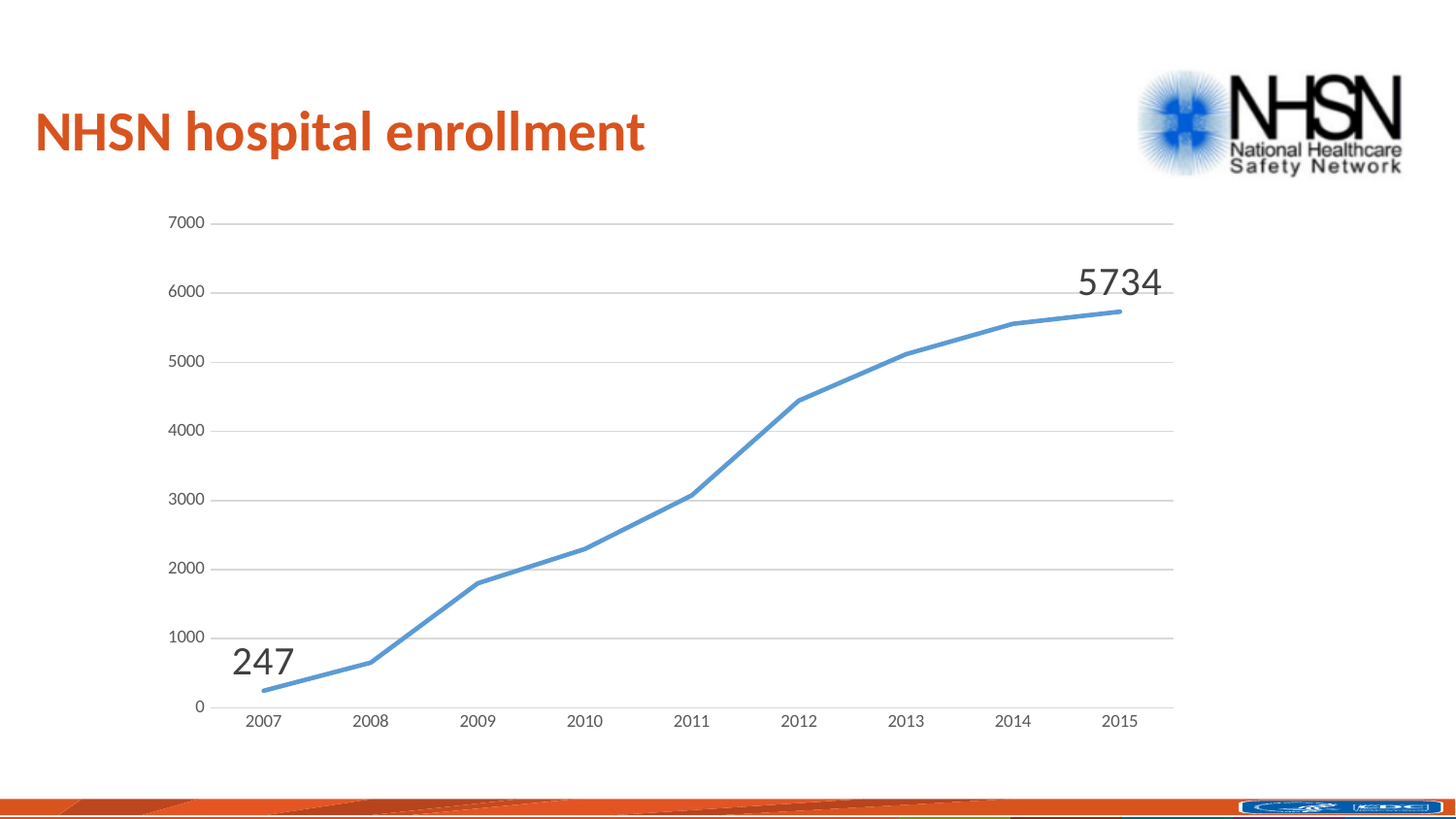
How many years are plotted on the x axis? 9 Is the value for 2009 greater or less than 2000? less Does hospital enrollment rise or fall from 2007 to 2015? rise Is the value for 2008 greater or less than 1000? less Which year has the lowest hospital enrollment? 2007 What type of chart is shown on the slide? line chart What is the title of the chart on the slide? NHSN hospital enrollment What is the NHSN hospital enrollment value for 2007? 247 Which year has the highest hospital enrollment? 2015 What is the difference in hospital enrollment between 2015 and 2007? 5487 Is the value for 2012 greater or less than 4000? greater What is the NHSN hospital enrollment value for 2015? 5734